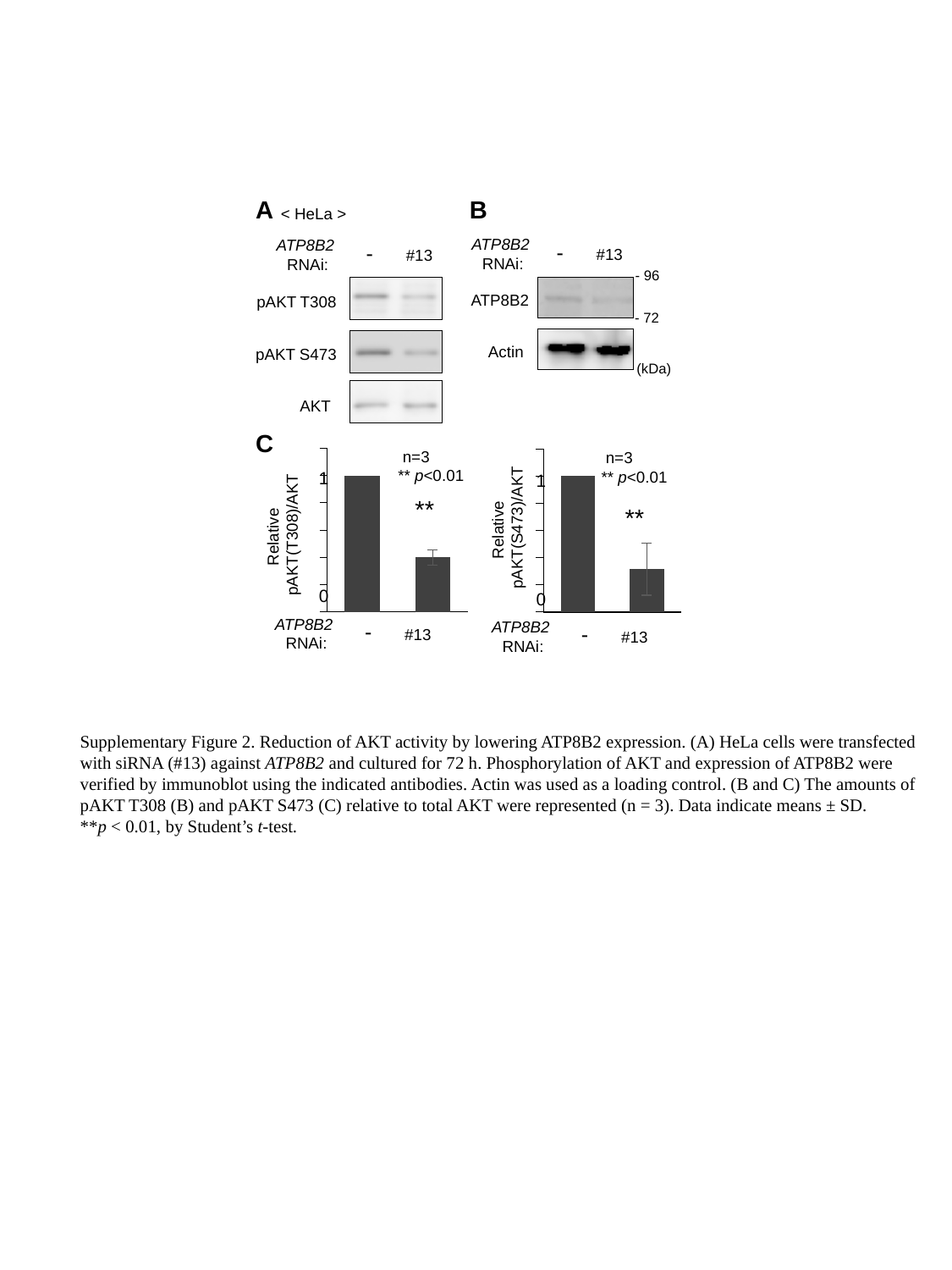
In panel C, how many bars does the right chart (Relative pAKT(S473)/AKT) show? 2 In panel C, what is the y-axis label of the right chart? Relative pAKT(S473)/AKT In the right chart of panel C (Relative pAKT(S473)/AKT), which ATP8B2 RNAi condition has the lowest bar? #13 In panel C, how many bars does the left chart (Relative pAKT(T308)/AKT) show? 2 In the right chart of panel C (Relative pAKT(S473)/AKT), is the value for #13 greater or less than 1? less In the right chart of panel C (Relative pAKT(S473)/AKT), what is the value for the '-' (control) ATP8B2 RNAi condition? 1 In the left chart of panel C (Relative pAKT(T308)/AKT), what is the value for the '-' (control) ATP8B2 RNAi condition? 1 In panel C, what kind of chart is the left chart (Relative pAKT(T308)/AKT)? bar chart In the left chart of panel C (Relative pAKT(T308)/AKT), which ATP8B2 RNAi condition has the highest bar? - In the left chart of panel C (Relative pAKT(T308)/AKT), is the bar for '-' or for '#13' larger? - In the left chart of panel C (Relative pAKT(T308)/AKT), is the value for #13 greater or less than 1? less In panel C, what sample size (n) is stated on the charts? n=3